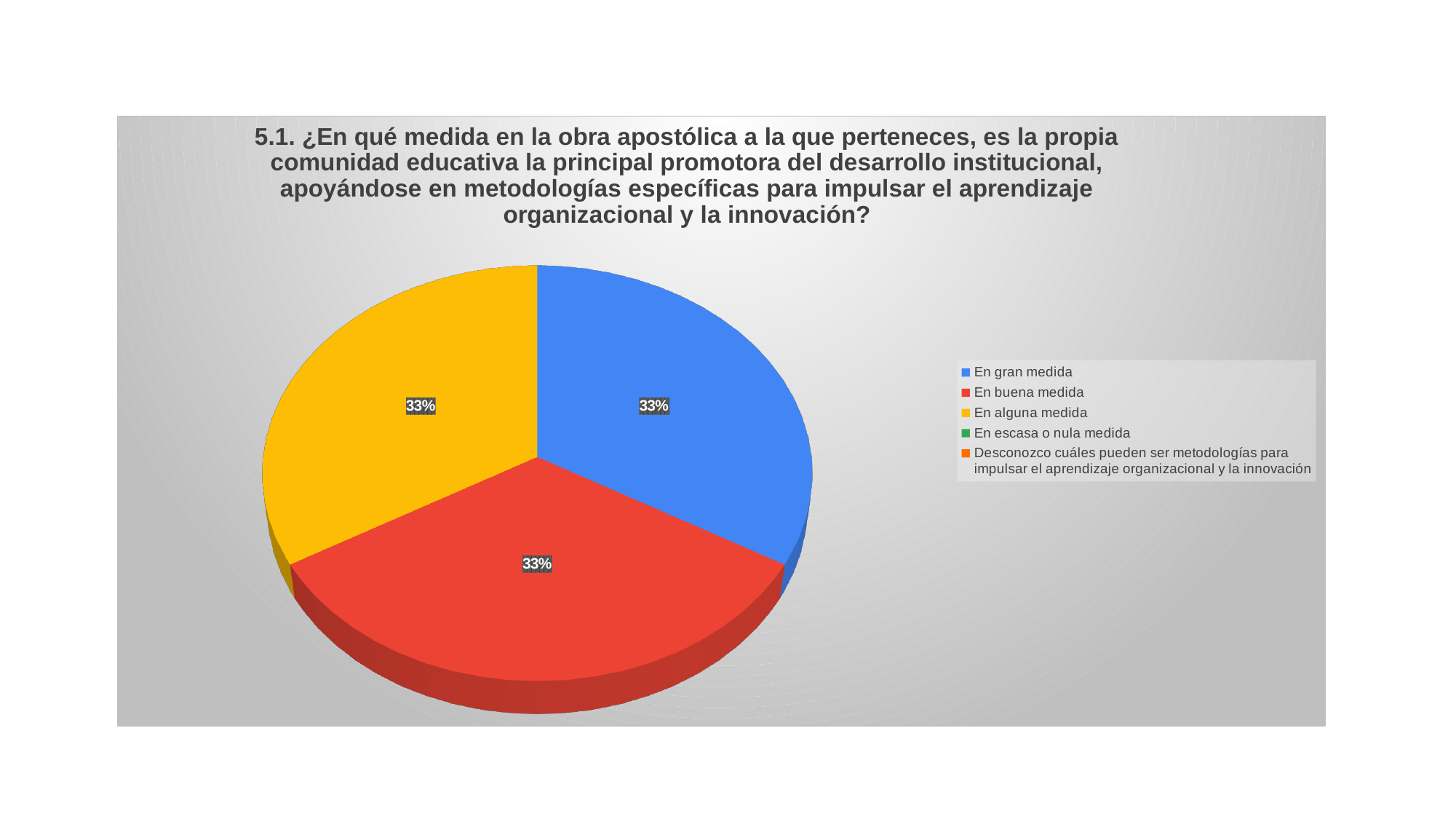
What percentage of the pie is labelled for "En gran medida"? 33% What share of the pie does "En alguna medida" represent? 33% Which legend entry is shown in blue? En gran medida Which legend entry is shown in yellow? En alguna medida What value is shown for the "En buena medida" slice? 33% How many slices with data labels are visible in the pie? 3 How many entries does the legend list? 5 Which colour represents "En buena medida" in the chart? Red What kind of chart is shown on the slide? Pie chart Is the value for "En gran medida" greater or less than 50%? less